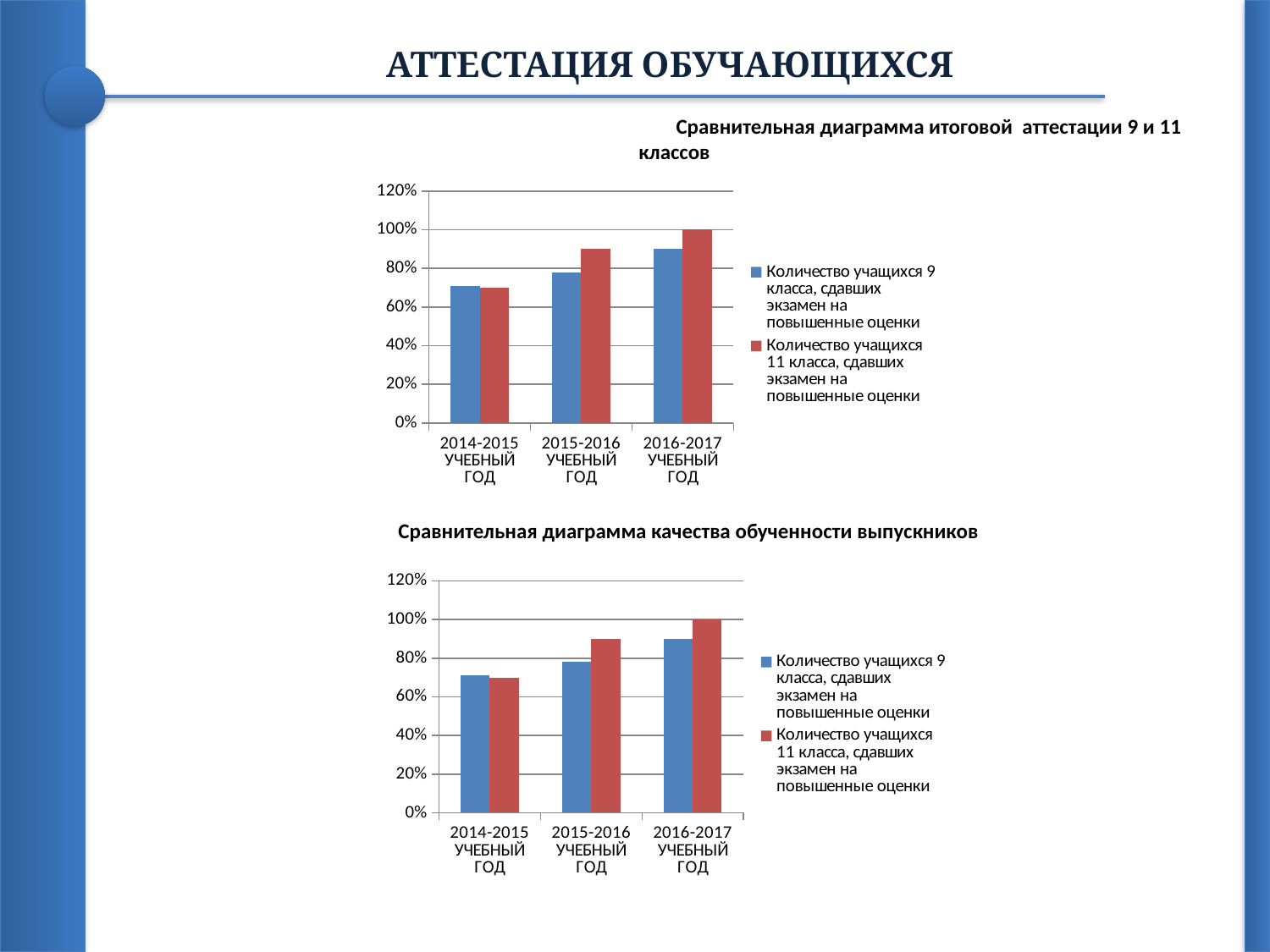
In the top chart, how many academic years are shown on the x axis? 3 What kind of chart is the bottom chart, 'Сравнительная диаграмма качества обученности выпускников'? bar chart In the top chart, how many series does the legend list? 2 In the top chart, is the value for 'Количество учащихся 9 класса, сдавших экзамен на повышенные оценки' in 2014-2015 учебный год greater or less than 80%? less In the top chart, what is the value for 'Количество учащихся 11 класса, сдавших экзамен на повышенные оценки' in 2016-2017 учебный год? 100% In the bottom chart, what colour are the bars for 'Количество учащихся 11 класса, сдавших экзамен на повышенные оценки'? red In the bottom chart, is the value for 'Количество учащихся 9 класса, сдавших экзамен на повышенные оценки' in 2016-2017 учебный год greater or less than 80%? greater In the top chart, do the values for 'Количество учащихся 9 класса, сдавших экзамен на повышенные оценки' rise or fall from 2014-2015 to 2016-2017? rise What kind of chart is the top chart, 'Сравнительная диаграмма итоговой аттестации 9 и 11 классов'? bar chart In the top chart, in 2015-2016 учебный год, which series has the larger value: 9 класса or 11 класса? 11 класса In the bottom chart, which academic year has the lowest value for 'Количество учащихся 11 класса, сдавших экзамен на повышенные оценки'? 2014-2015 учебный год In the top chart, which academic year has the highest value for 'Количество учащихся 11 класса, сдавших экзамен на повышенные оценки'? 2016-2017 учебный год